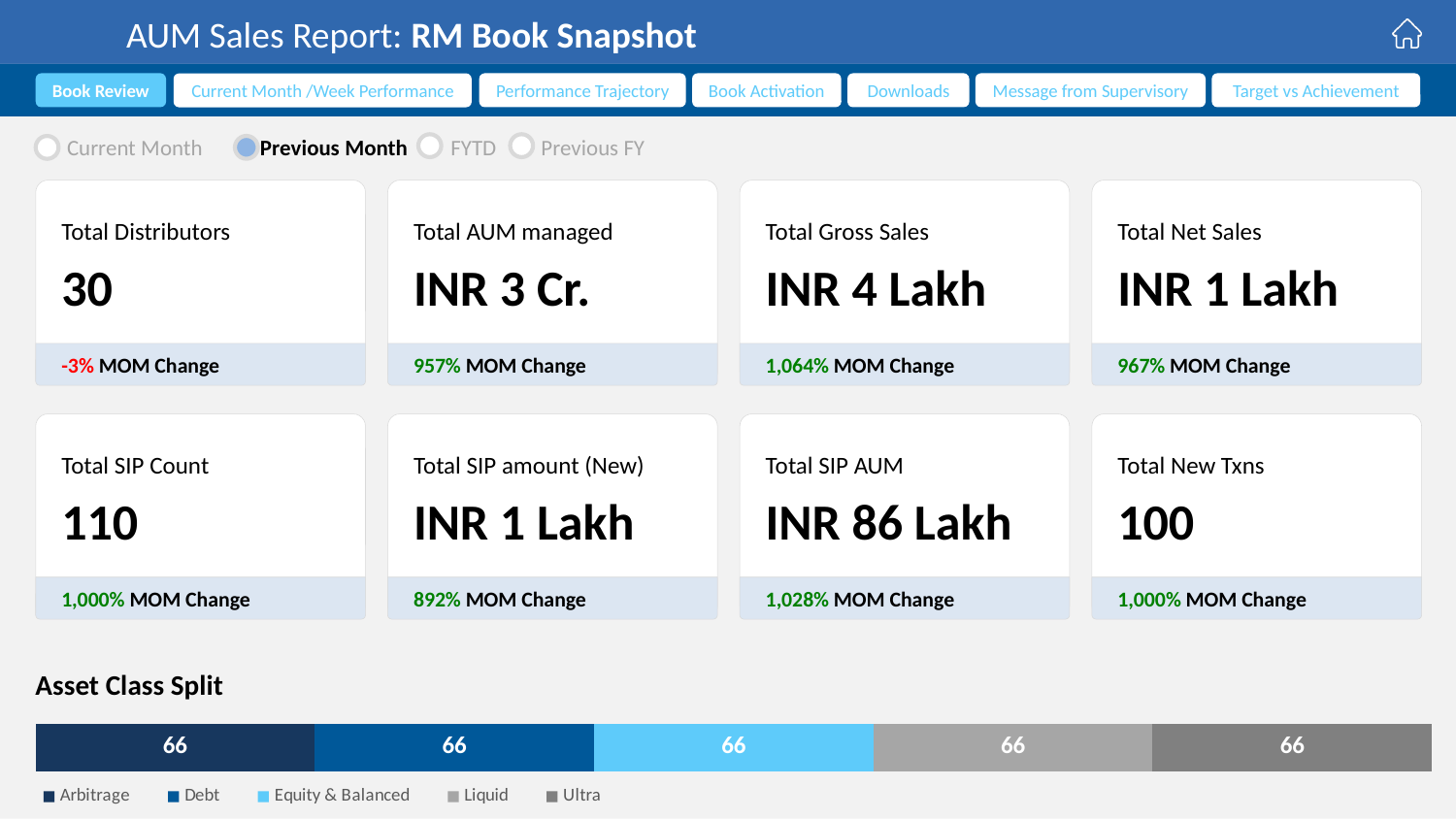
In the Asset Class Split chart, what is the value for Arbitrage? 66 How many segments make up the Asset Class Split stacked bar? 5 In the Asset Class Split chart, what is the value for Debt? 66 What is the title of the stacked bar chart at the bottom of the slide? Asset Class Split What kind of chart is the Asset Class Split chart? bar chart In the Asset Class Split chart, what is the value for Ultra? 66 In the Asset Class Split chart, what is the difference between the Debt value and the Liquid value? 0 What is the total of all segments in the Asset Class Split stacked bar? 330 In the Asset Class Split chart, what is the value for Equity & Balanced? 66 In the Asset Class Split chart, which legend entry is shown in light blue? Equity & Balanced In the Asset Class Split chart, what is the value for Liquid? 66 How many series does the legend of the Asset Class Split chart list? 5